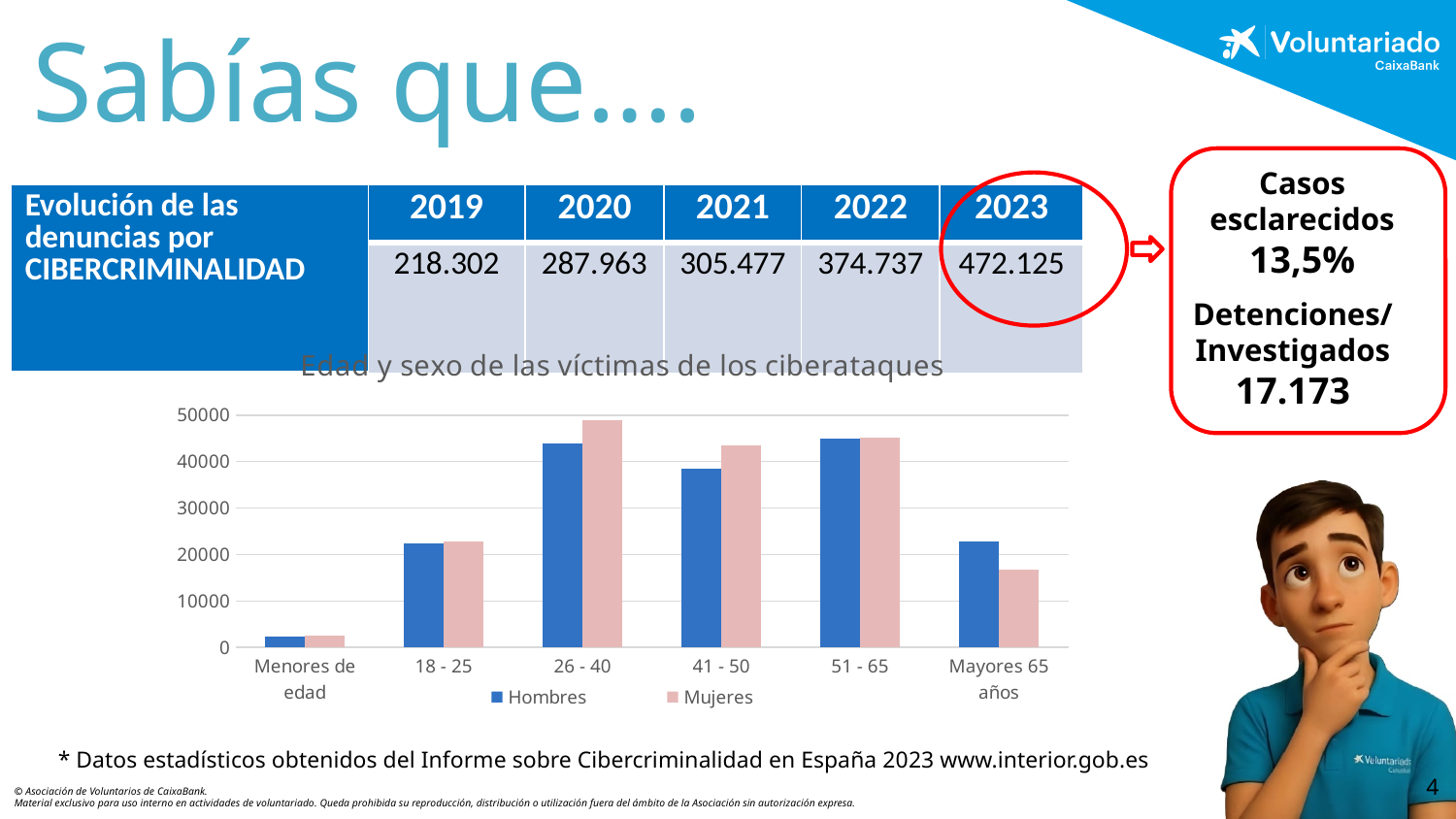
In the bar chart, for the 41 - 50 category, which is larger: Hombres or Mujeres? Mujeres How many series does the legend of the bar chart list? 2 In the bar chart, for the 'Mayores 65 años' category, which is larger: Hombres or Mujeres? Hombres In the bar chart, is the value for Mujeres in the 'Mayores 65 años' category greater or less than 20000? less What are the two series named in the legend of the bar chart? Hombres and Mujeres In the bar chart, which age category has the lowest value for Hombres? Menores de edad In the bar chart, is the value for Hombres in the 18 - 25 category greater or less than 20000? greater In the bar chart, is the value for Hombres in the 'Menores de edad' category greater or less than 10000? less What kind of chart is 'Edad y sexo de las víctimas de los ciberataques'? bar chart In the bar chart, which age category has the highest value for Mujeres? 26 - 40 How many age categories are shown on the x axis of the bar chart? 6